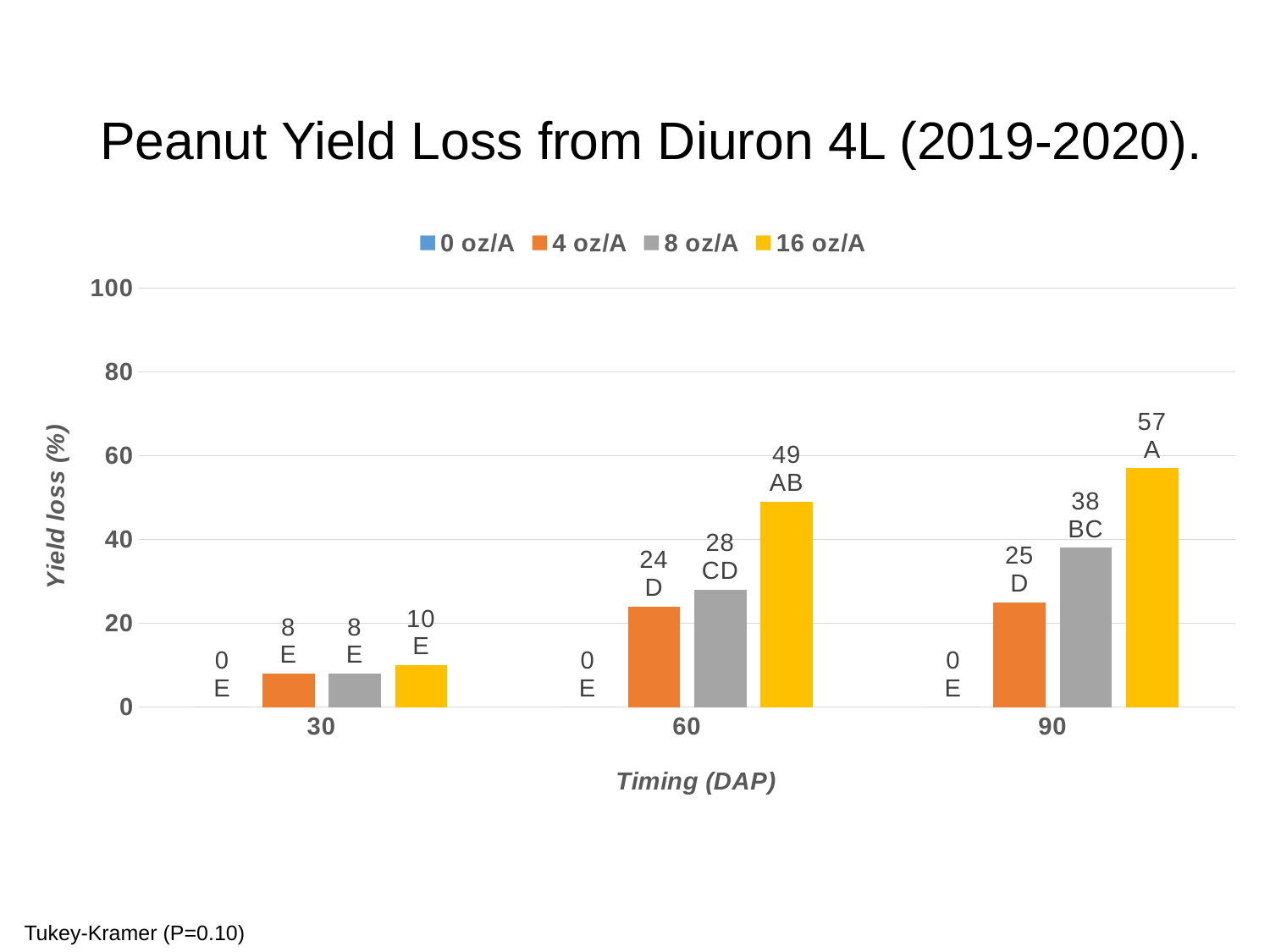
What is the title of the chart? Peanut Yield Loss from Diuron 4L (2019-2020). How many series does the legend list? 4 What is the yield loss for 16 oz/A at 90 DAP? 57 What is the yield loss for 8 oz/A at 60 DAP? 28 Which is larger, the yield loss for 8 oz/A at 90 DAP or for 16 oz/A at 60 DAP? 16 oz/A at 60 DAP What is the yield loss for 4 oz/A at 30 DAP? 8 Which rate has the lowest yield loss at 60 DAP? 0 oz/A Does the yield loss for 16 oz/A rise or fall as timing increases from 30 to 90 DAP? rise What is the difference in yield loss between 16 oz/A and 4 oz/A at 60 DAP? 25 What kind of chart is shown on the slide? bar chart How many timing categories are shown on the x axis? 3 Which timing has the highest yield loss for the 16 oz/A rate? 90